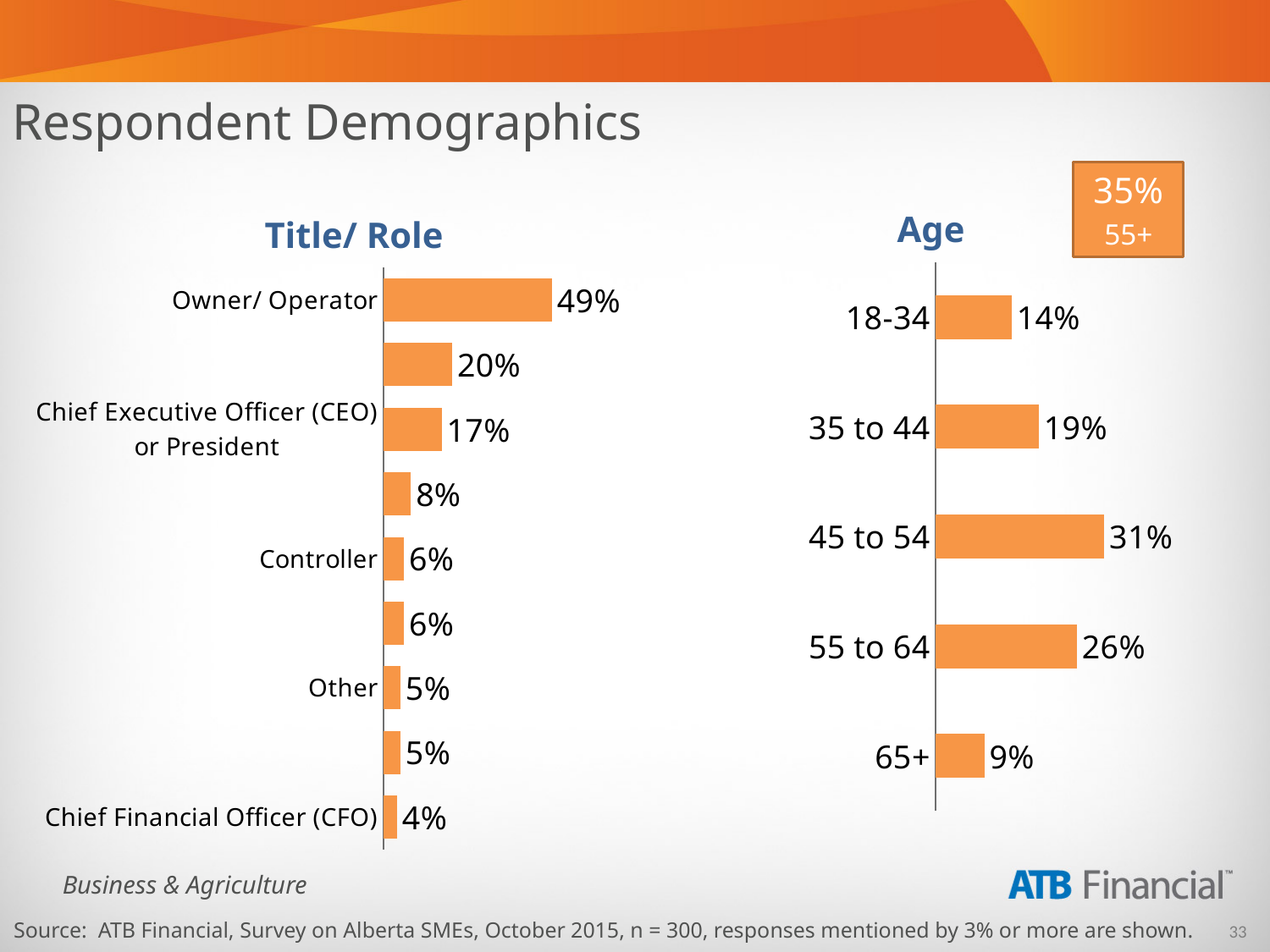
What type of chart is the Age chart? Bar chart In the Age chart, what percentage of respondents are aged 45 to 54? 31% In the Title/ Role chart, what percentage of respondents are Controller? 6% How many age groups are shown in the Age chart? 5 In the Age chart, which is larger: the 35 to 44 group or the 55 to 64 group? 55 to 64 In the Age chart, which age group has the highest percentage? 45 to 54 In the Title/ Role chart, what percentage of respondents are Chief Financial Officer (CFO)? 4% According to the callout box on the Age chart, what percentage of respondents are 55+? 35% In the Title/ Role chart, what percentage of respondents are Owner/ Operator? 49% In the Age chart, what is the difference between the 45 to 54 group and the 18-34 group? 17% In the Age chart, which age group has the lowest percentage? 65+ In the Age chart, what percentage of respondents are aged 65+? 9%